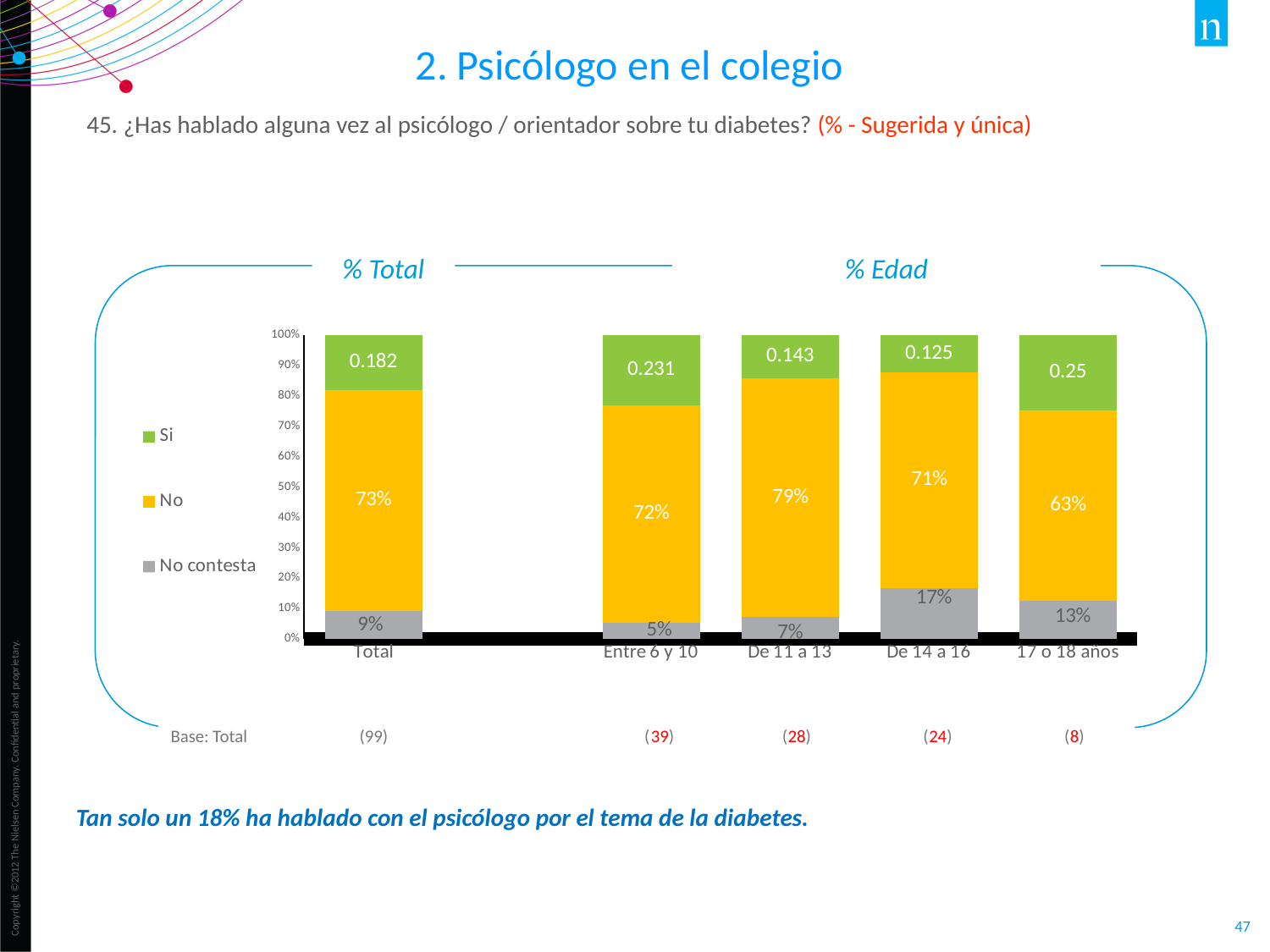
What is the value of the "Si" series for the "17 o 18 años" category? 0.25 Is the "No" value for the Total category greater or less than 50%? greater Which is larger: the "No contesta" value for "De 14 a 16" or for "17 o 18 años"? De 14 a 16 What kind of chart is shown on the slide? Stacked bar chart How many series does the legend list? 3 What is the value of the "Si" series for the "Entre 6 y 10" category? 0.231 Which category has the highest value for the "No" series? De 11 a 13 What is the difference between the "No" values for "De 11 a 13" and "17 o 18 años"? 16 percentage points Which category has the lowest value for the "No contesta" series? Entre 6 y 10 What is the value of the "No" series for the Total category? 73% How many categories are shown on the x axis of the chart? 5 What is the value of the "No contesta" series for the "De 14 a 16" category? 17%